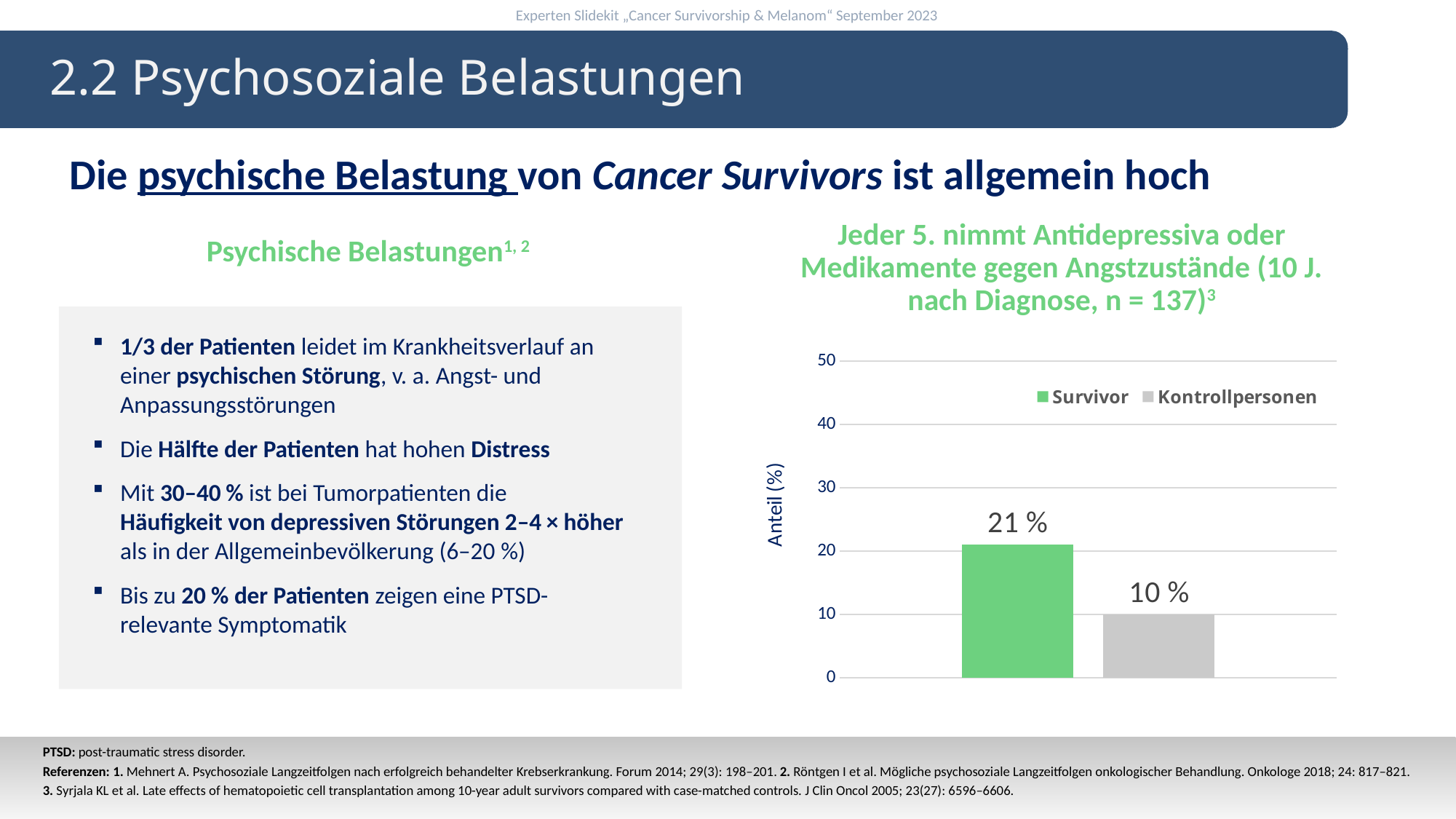
What is the maximum value shown on the y axis of the chart? 50 What is the label of the y axis of the chart? Anteil (%) What kind of chart is shown on the slide? bar chart Which group has the lowest value in the chart? Kontrollpersonen How many series does the chart legend list? 2 What is the difference between the Survivor and Kontrollpersonen values? 11 % Is the value for Survivor greater or less than 20? greater What colour is the Survivor bar in the chart? green How many bars are plotted in the chart? 2 What is the value for Survivor in the chart? 21 % What is the value for Kontrollpersonen in the chart? 10 % Which group has the higher value, Survivor or Kontrollpersonen? Survivor